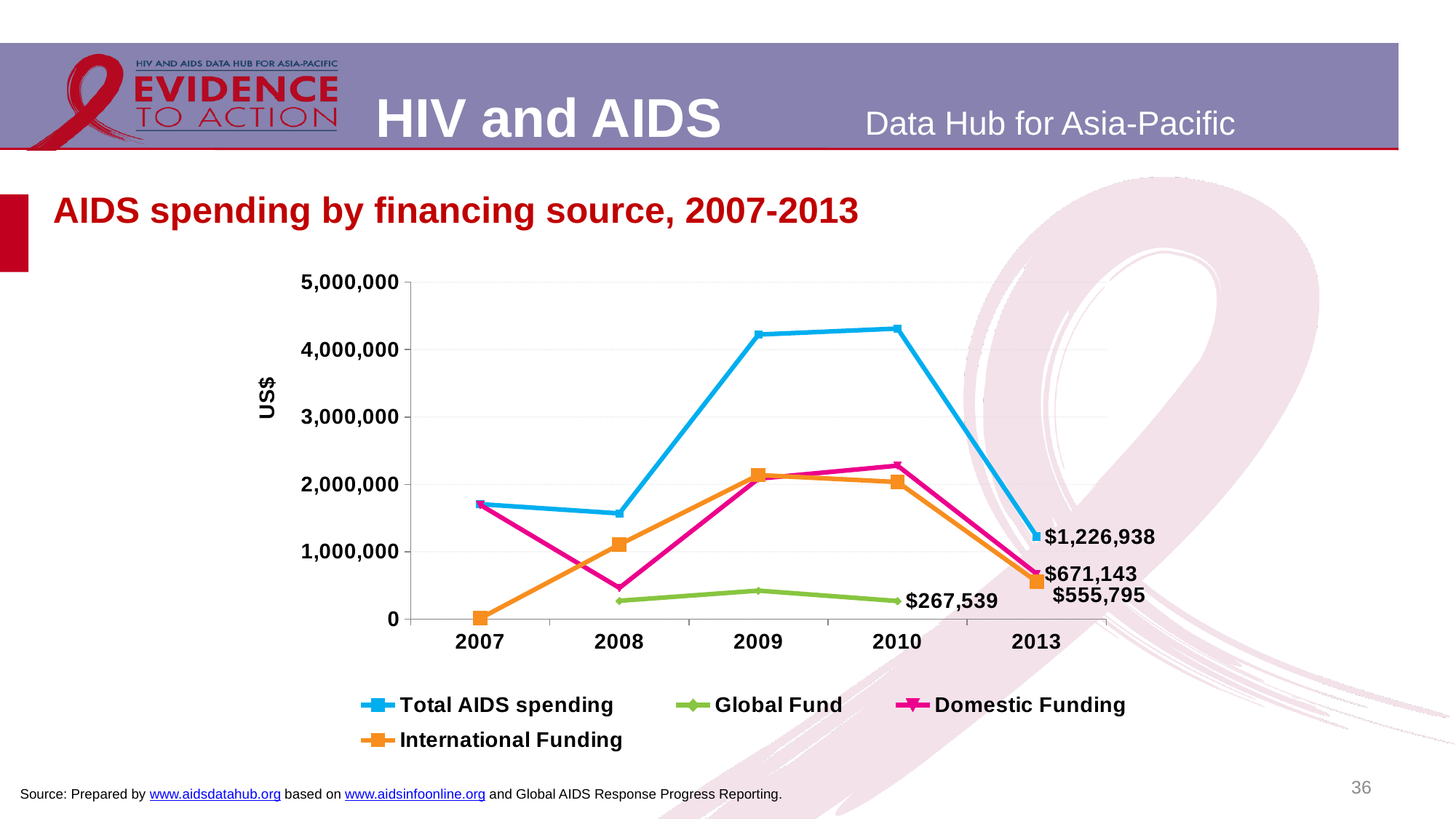
In which year is International Funding lowest? 2007 Is the value for Total AIDS spending in 2010 greater or less than 4,000,000? greater How many years are shown on the x axis? 5 What is the value of Domestic Funding in 2013? $671,143 What is the difference between Domestic Funding and International Funding in 2013? $115,348 What kind of chart is shown on the slide? Line chart What is the labelled value at the end of the Global Fund line? $267,539 How many series does the legend list? 4 Is the value for Domestic Funding in 2008 greater or less than 1,000,000? less What is the value of International Funding in 2013? $555,795 In 2013, which is larger: Domestic Funding or International Funding? Domestic Funding What is the value of Total AIDS spending in 2013? $1,226,938